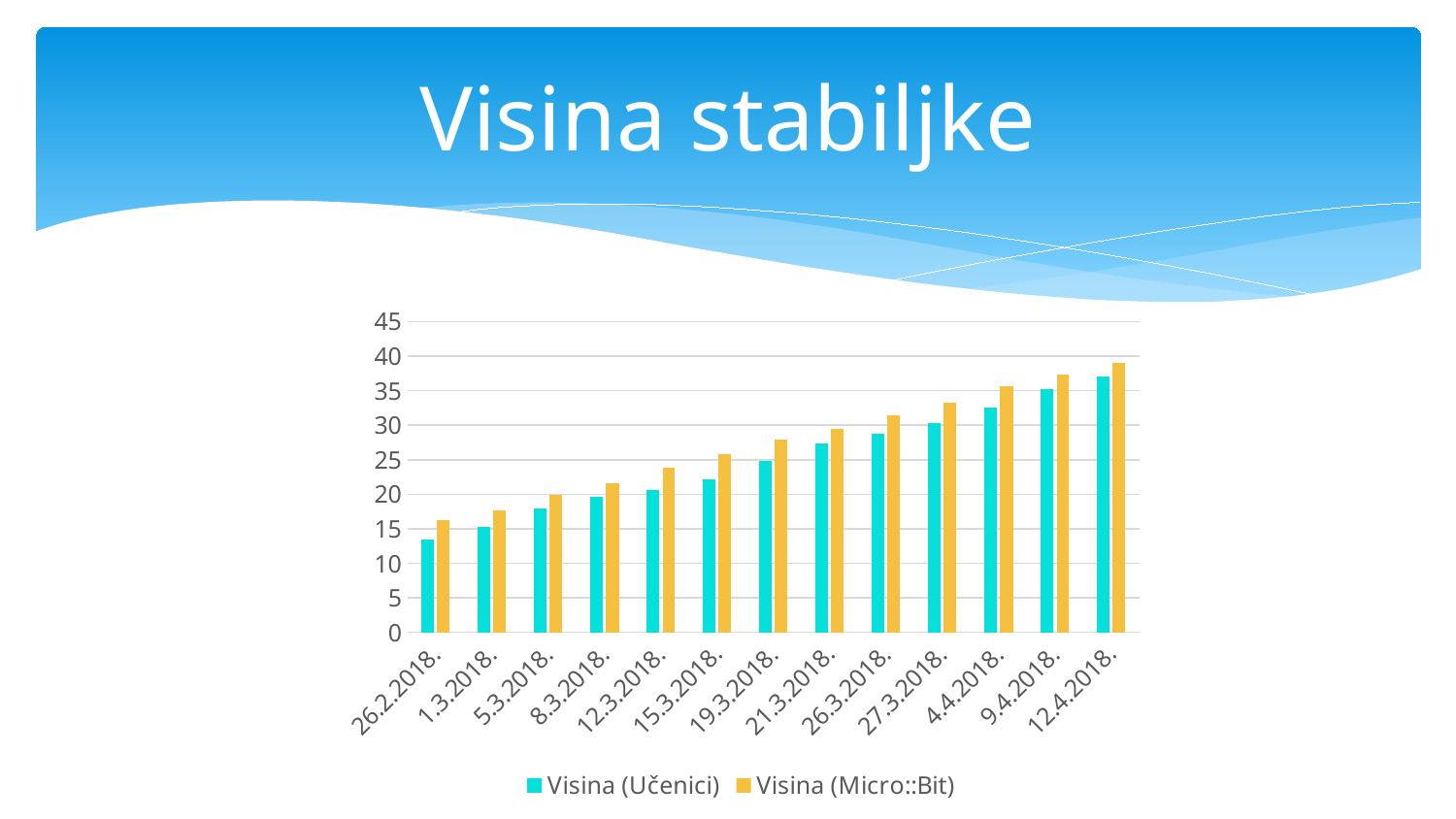
Is the value for Visina (Učenici) on 26.2.2018. greater or less than 15? less How many dates are shown on the x axis? 13 What kind of chart is shown on the slide? bar chart Do the values for Visina (Učenici) rise or fall from 26.2.2018. to 12.4.2018.? rise Is the value for Visina (Micro::Bit) on 26.3.2018. greater or less than 30? greater On 26.2.2018., which series has the larger value, Visina (Učenici) or Visina (Micro::Bit)? Visina (Micro::Bit) On which date is the value for Visina (Micro::Bit) highest? 12.4.2018. How many series does the legend list? 2 On which date is the value for Visina (Učenici) lowest? 26.2.2018. Is the value for Visina (Micro::Bit) on 12.4.2018. greater or less than 35? greater Which series is shown in yellow bars? Visina (Micro::Bit)